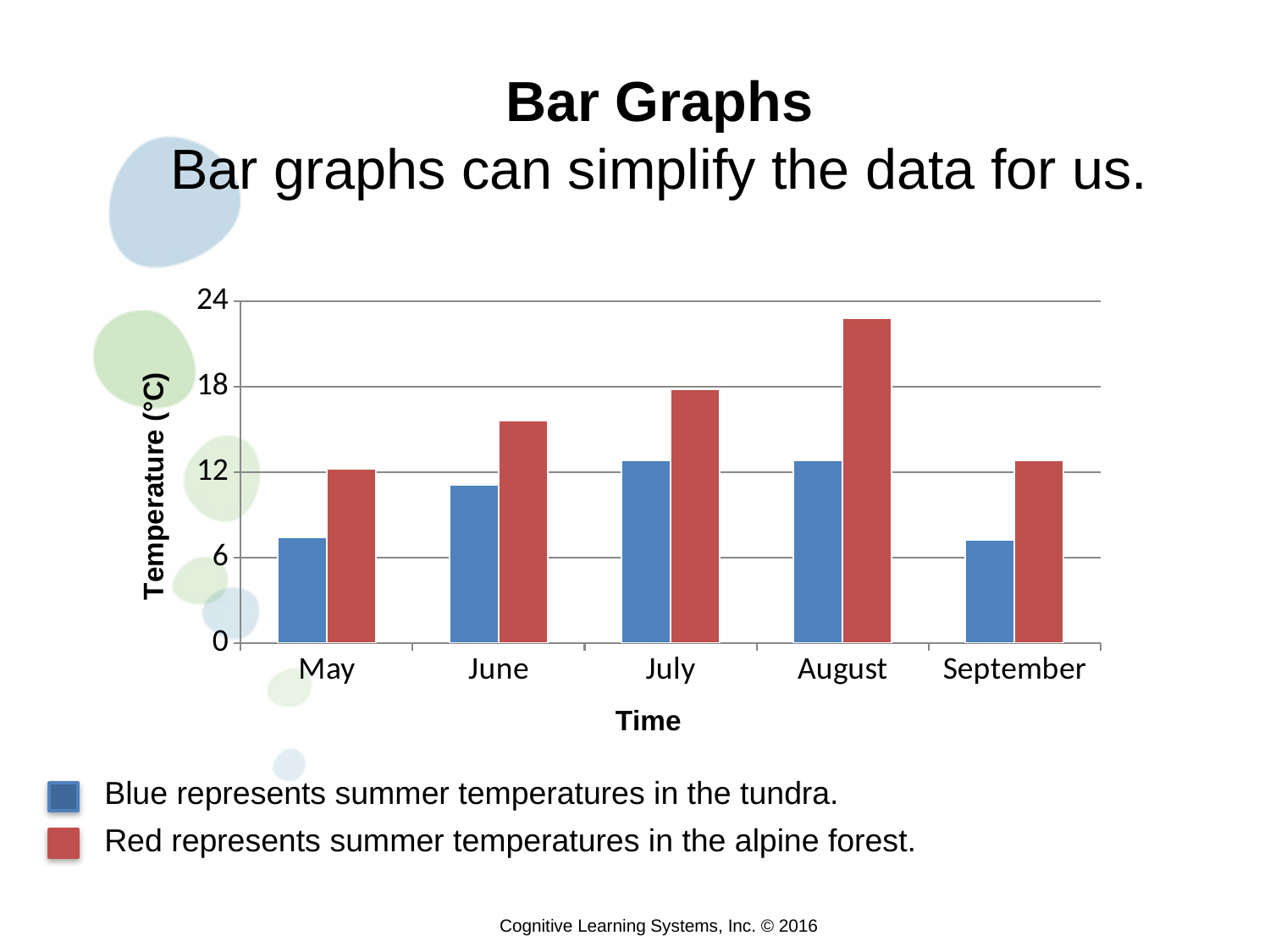
What kind of chart is shown on the slide? Bar chart Does the alpine forest (red) temperature rise or fall from May to August? Rise What is the label on the vertical axis of the chart? Temperature (°C) What is the label on the horizontal axis of the chart? Time In July, which is larger: the tundra (blue) temperature or the alpine forest (red) temperature? Alpine forest (red) How many data series does the chart show? 2 Is the tundra (blue) temperature for May greater or less than 6? greater Is the alpine forest (red) temperature for August greater or less than 18? greater Is the tundra (blue) temperature for June greater or less than 12? less Which month has the highest alpine forest (red) temperature? August How many months are shown on the x axis of the chart? 5